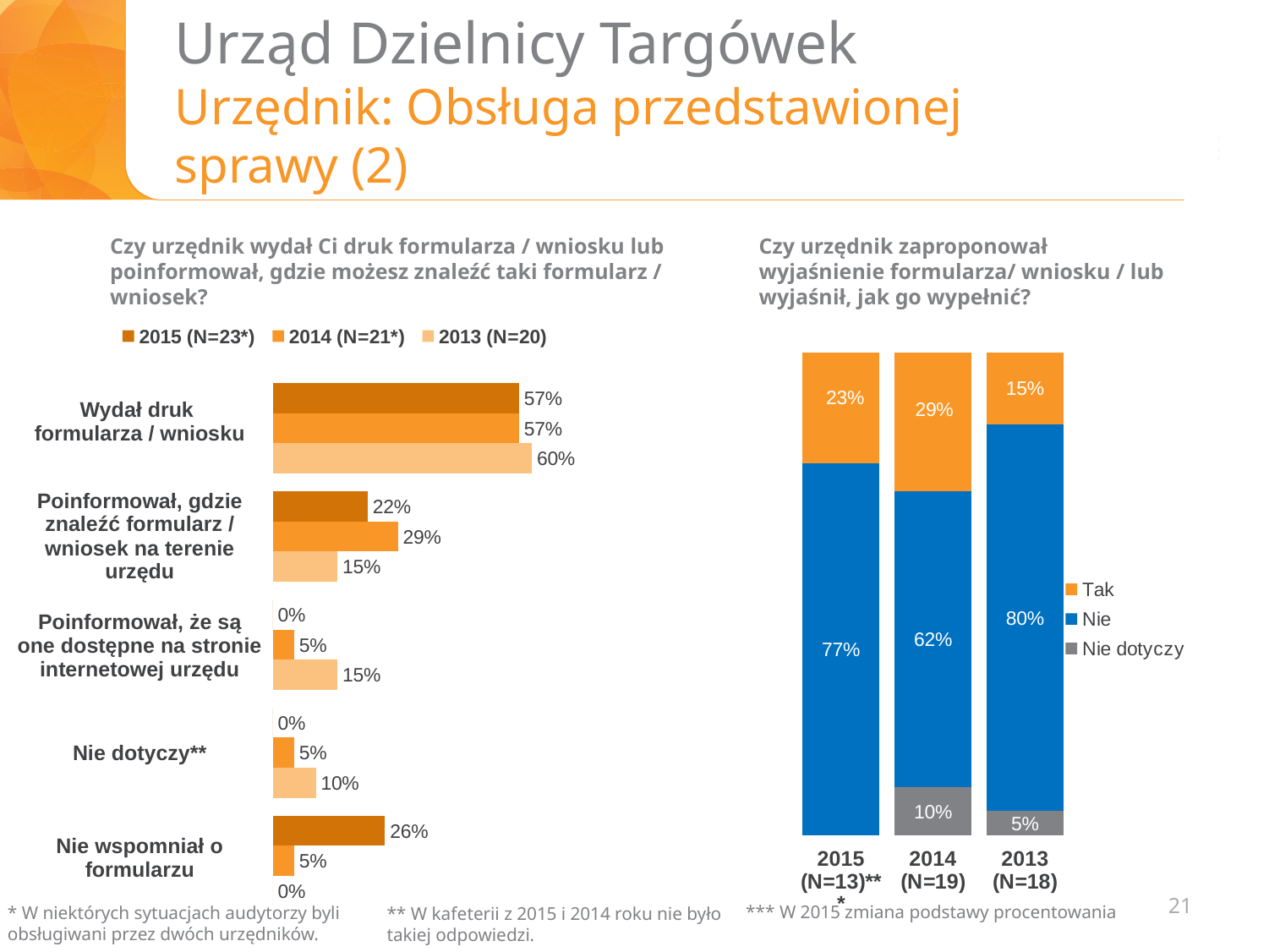
In the right chart, is the "Tak" value for 2015 (N=13)** larger or smaller than the "Tak" value for 2014 (N=19)? Smaller What kind of chart is the left chart? Bar chart In the right chart, what is the "Tak" value for 2013 (N=18)? 15% In the left chart, how many categories are shown? 5 In the left chart, how many series does the legend list? 3 In the left chart, which category has the highest 2015 (N=23*) value? Wydał druk formularza / wniosku In the left chart, what is the difference between the 2015 and 2014 values for "Nie wspomniał o formularzu"? 21 percentage points In the right chart, which year has the highest "Nie" value? 2013 (N=18) In the left chart, what is the 2015 (N=23*) value for "Nie wspomniał o formularzu"? 26% In the left chart, what is the 2014 (N=21*) value for "Poinformował, gdzie znaleźć formularz / wniosek na terenie urzędu"? 29% In the right chart, what is the "Nie" value for 2014 (N=19)? 62% In the left chart, what is the 2013 (N=20) value for "Wydał druk formularza / wniosku"? 60%